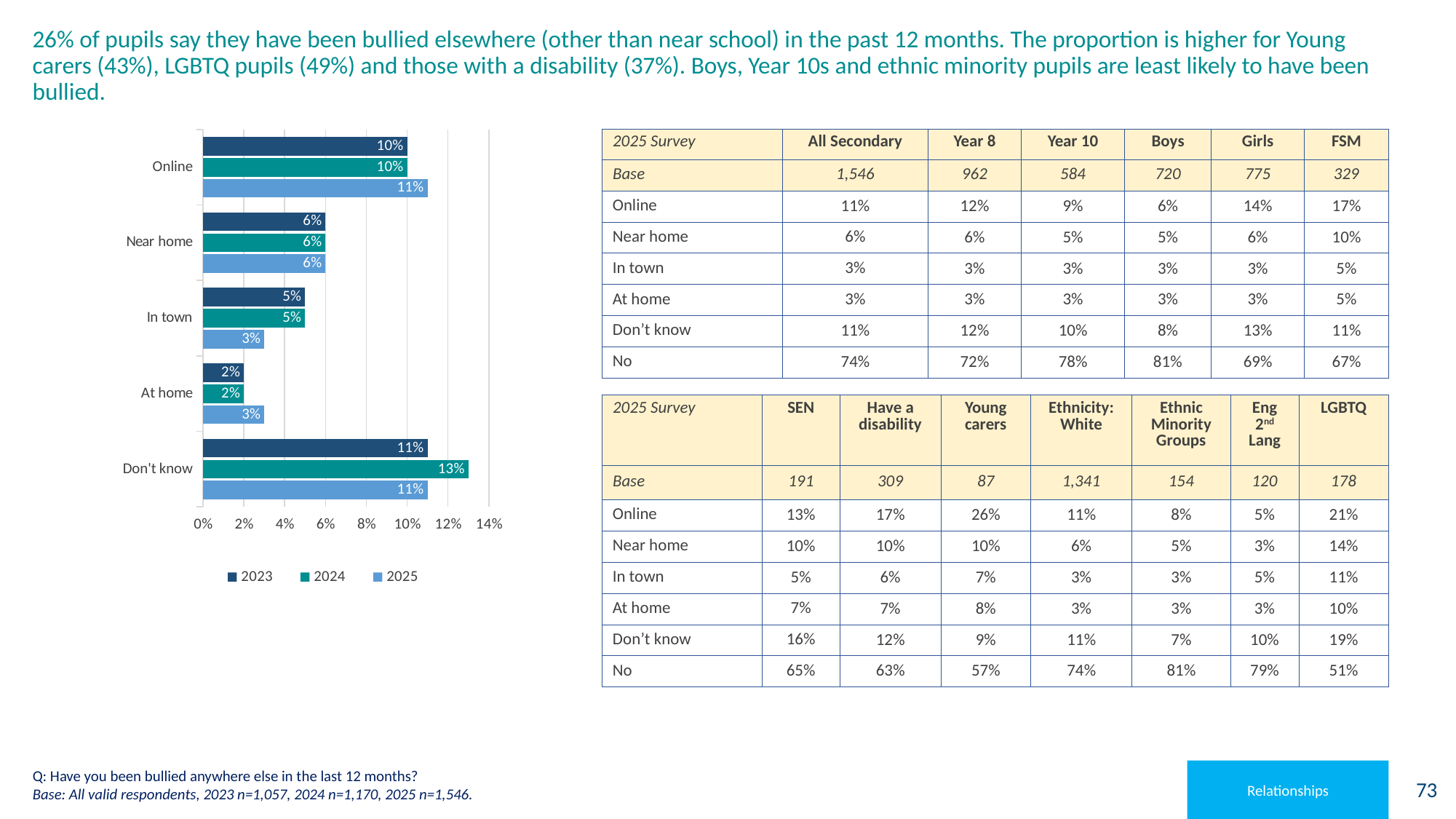
Which category has the highest 2024 value in the bar chart? Don't know What is the 2025 value for Online in the bar chart? 11% Which category has the lowest 2023 value in the bar chart? At home Which years are listed in the bar chart's legend? 2023, 2024, 2025 How many series does the bar chart's legend list? 3 What is the difference between the 2024 and 2025 values for Don't know in the bar chart? 2% What kind of chart is shown on the slide? Bar chart How many categories are shown on the bar chart? 5 What is the 2024 value for Don't know in the bar chart? 13% What is the 2025 value for In town in the bar chart? 3% What is the 2023 value for At home in the bar chart? 2% Which is larger in the bar chart: the 2023 value for In town or the 2025 value for In town? 2023